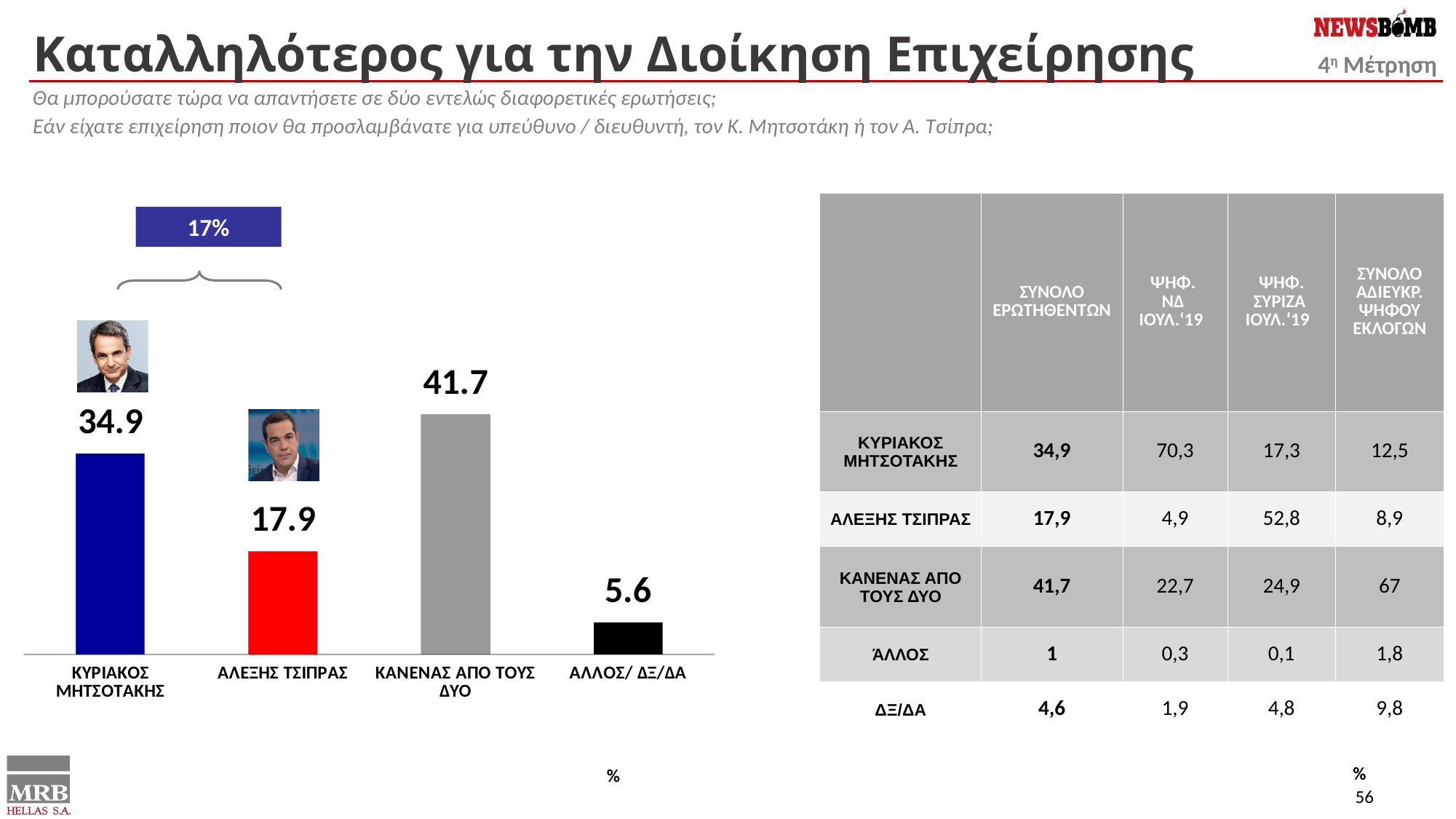
Which category has the highest value in the bar chart? ΚΑΝΕΝΑΣ ΑΠΟ ΤΟΥΣ ΔΥΟ What kind of chart is shown on the left of the slide? Bar chart What value is shown for ΑΛΛΟΣ/ ΔΞ/ΔΑ in the bar chart? 5.6 Which is larger in the bar chart: the value for ΚΥΡΙΑΚΟΣ ΜΗΤΣΟΤΑΚΗΣ or the value for ΚΑΝΕΝΑΣ ΑΠΟ ΤΟΥΣ ΔΥΟ? ΚΑΝΕΝΑΣ ΑΠΟ ΤΟΥΣ ΔΥΟ How many categories are shown in the bar chart? 4 What value is shown for ΑΛΕΞΗΣ ΤΣΙΠΡΑΣ in the bar chart? 17.9 What value is shown for ΚΥΡΙΑΚΟΣ ΜΗΤΣΟΤΑΚΗΣ in the bar chart? 34.9 What colour is the bar for ΑΛΕΞΗΣ ΤΣΙΠΡΑΣ? Red What is the difference between the values for ΚΥΡΙΑΚΟΣ ΜΗΤΣΟΤΑΚΗΣ and ΑΛΕΞΗΣ ΤΣΙΠΡΑΣ in the bar chart? 17 What percentage is shown in the blue box above the bracket linking the first two bars? 17% Which category has the lowest value in the bar chart? ΑΛΛΟΣ/ ΔΞ/ΔΑ What value is shown for ΚΑΝΕΝΑΣ ΑΠΟ ΤΟΥΣ ΔΥΟ in the bar chart? 41.7